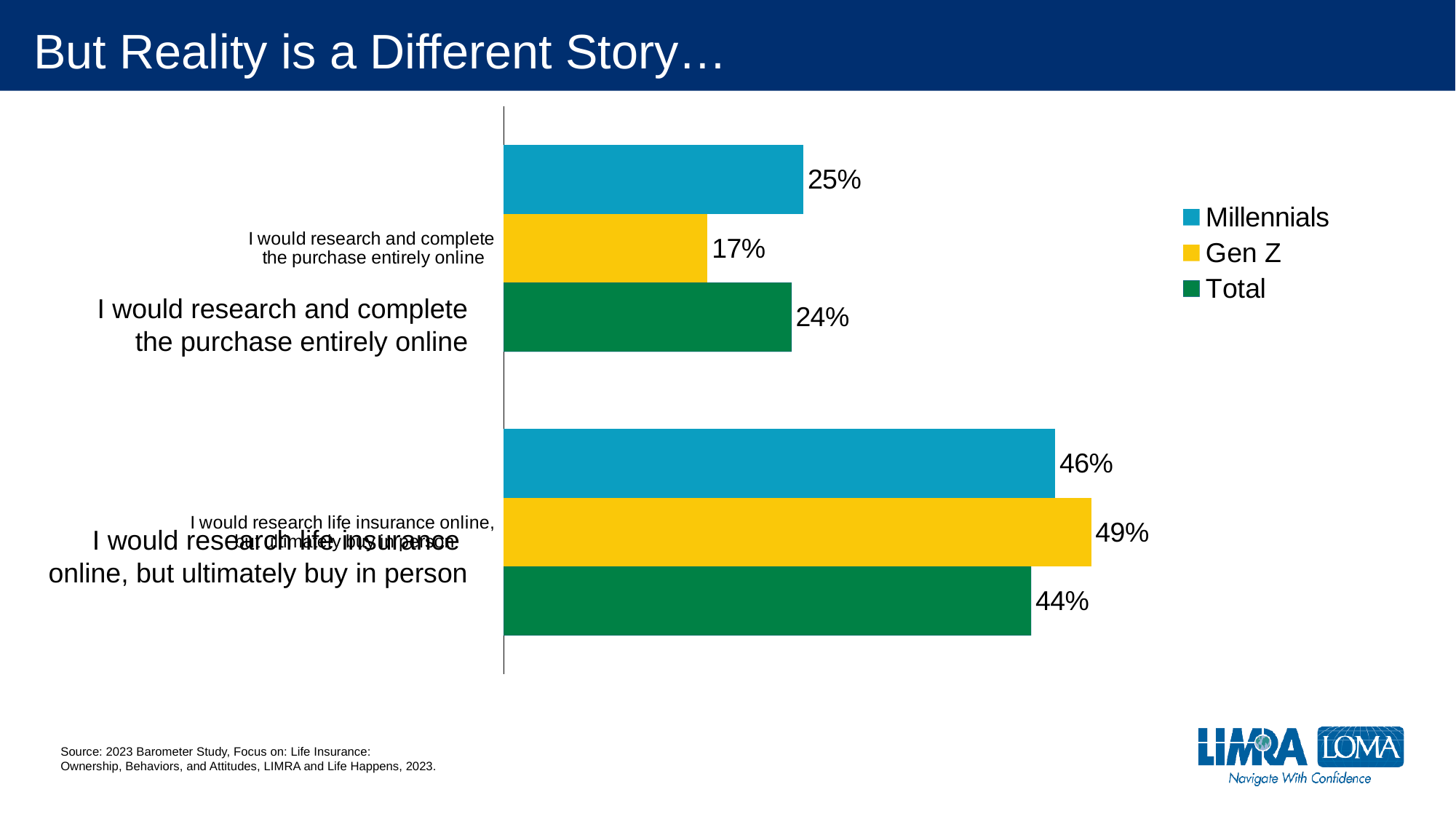
What is the value for Gen Z for "I would research and complete the purchase entirely online"? 17% What kind of chart is shown on the slide? Bar chart What is the difference between the Millennials and Gen Z values for "I would research and complete the purchase entirely online"? 8% Which is larger: the Millennials value for researching and completing the purchase entirely online, or the Total value for the same statement? Millennials What is the value for Gen Z for "I would research life insurance online, but ultimately buy in person"? 49% How many series does the legend list? 3 Which series has the highest value for "I would research life insurance online, but ultimately buy in person"? Gen Z What is the Total value for "I would research life insurance online, but ultimately buy in person"? 44% Which colour represents Gen Z in the chart? Yellow Which series has the lowest value for "I would research and complete the purchase entirely online"? Gen Z What is the value for Millennials for "I would research and complete the purchase entirely online"? 25% What is the difference between the Gen Z and Total values for "I would research life insurance online, but ultimately buy in person"? 5%